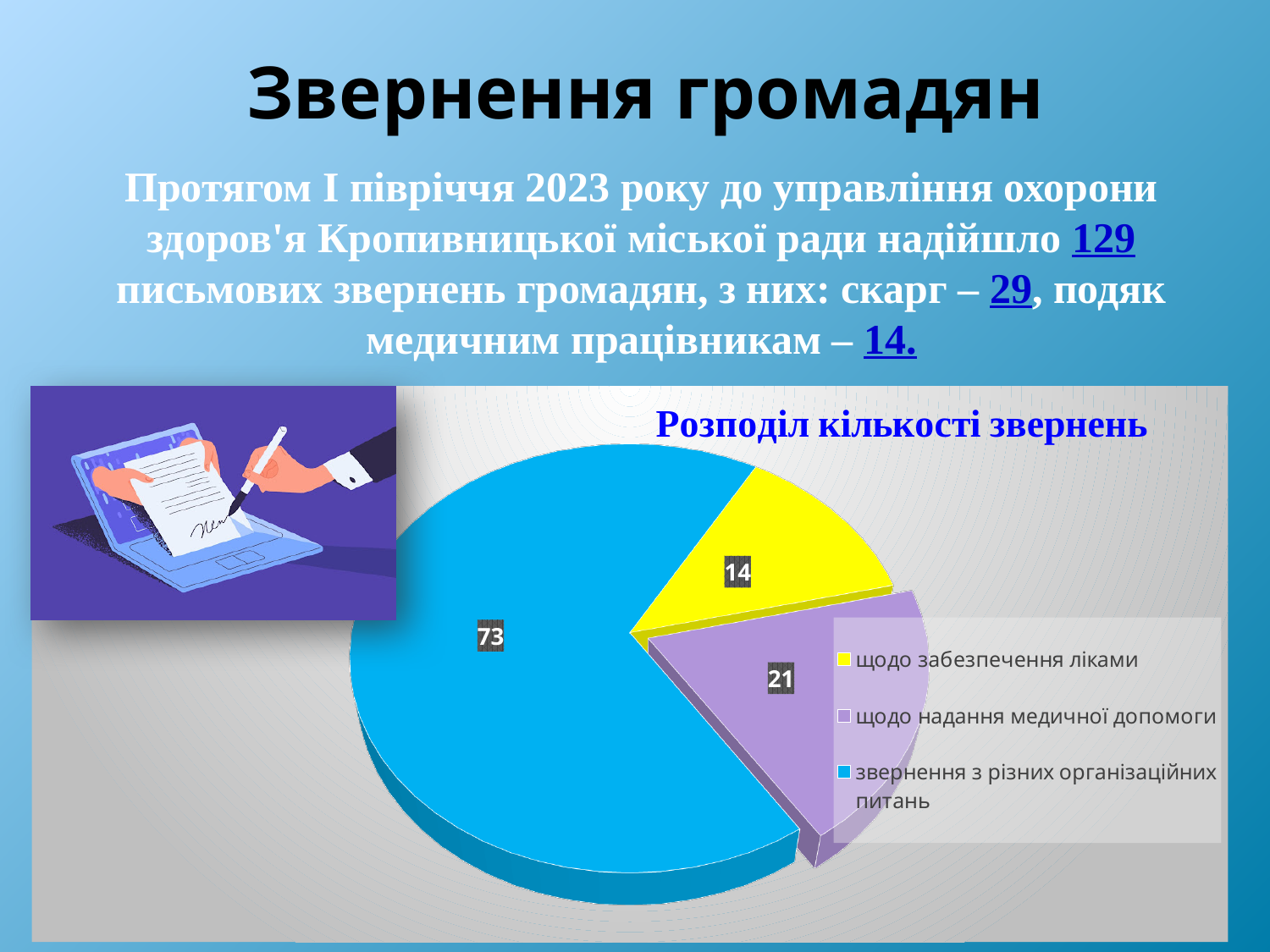
Which category has the largest slice of the pie? звернення з різних організаційних питань What is the value for "щодо забезпечення ліками"? 14 Which is larger: the value for "щодо надання медичної допомоги" or for "щодо забезпечення ліками"? щодо надання медичної допомоги What is the value for "звернення з різних організаційних питань"? 73 What is the value for "щодо надання медичної допомоги"? 21 What is the difference between the values for "звернення з різних організаційних питань" and "щодо надання медичної допомоги"? 52 What is the title of the chart? Розподіл кількості звернень What type of chart is shown on the slide? pie chart What colour is the slice for "щодо забезпечення ліками"? yellow How many entries does the chart legend list? 3 Which category has the smallest slice of the pie? щодо забезпечення ліками How many slices does the pie chart have? 3